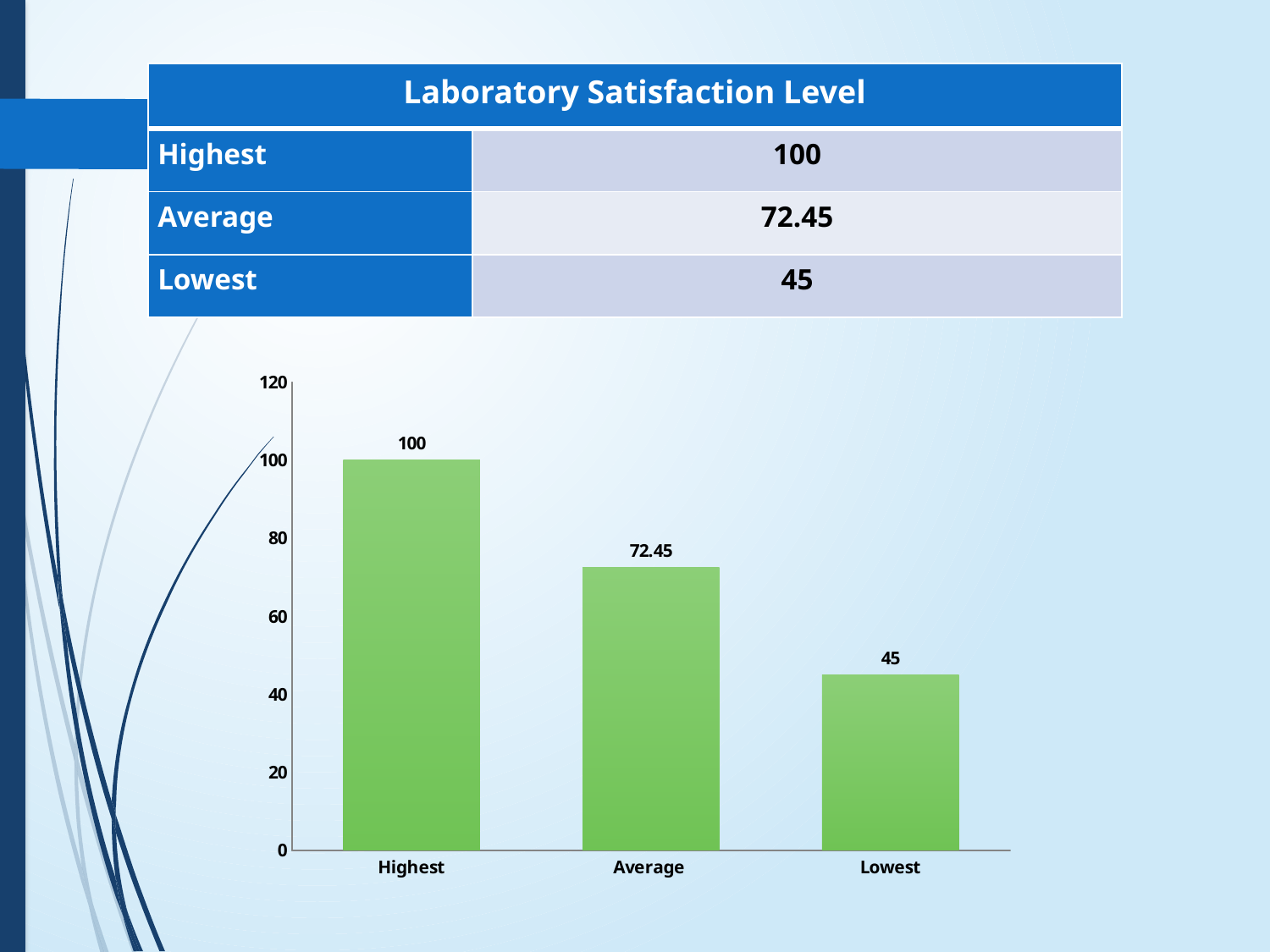
Which category has the highest value? Highest How many categories are shown on the x axis? 3 What kind of chart is shown on the slide? bar chart What is the value of the Average bar? 72.45 Which is larger, the Average value or the Lowest value? Average What is the difference between the Highest and Average values? 27.55 What is the difference between the Highest and Lowest values? 55 Which category has the lowest value? Lowest Is the value for Average greater or less than 80? less What is the value of the Highest bar? 100 What is the value of the Lowest bar? 45 Do the values rise or fall from left to right along the x axis? fall